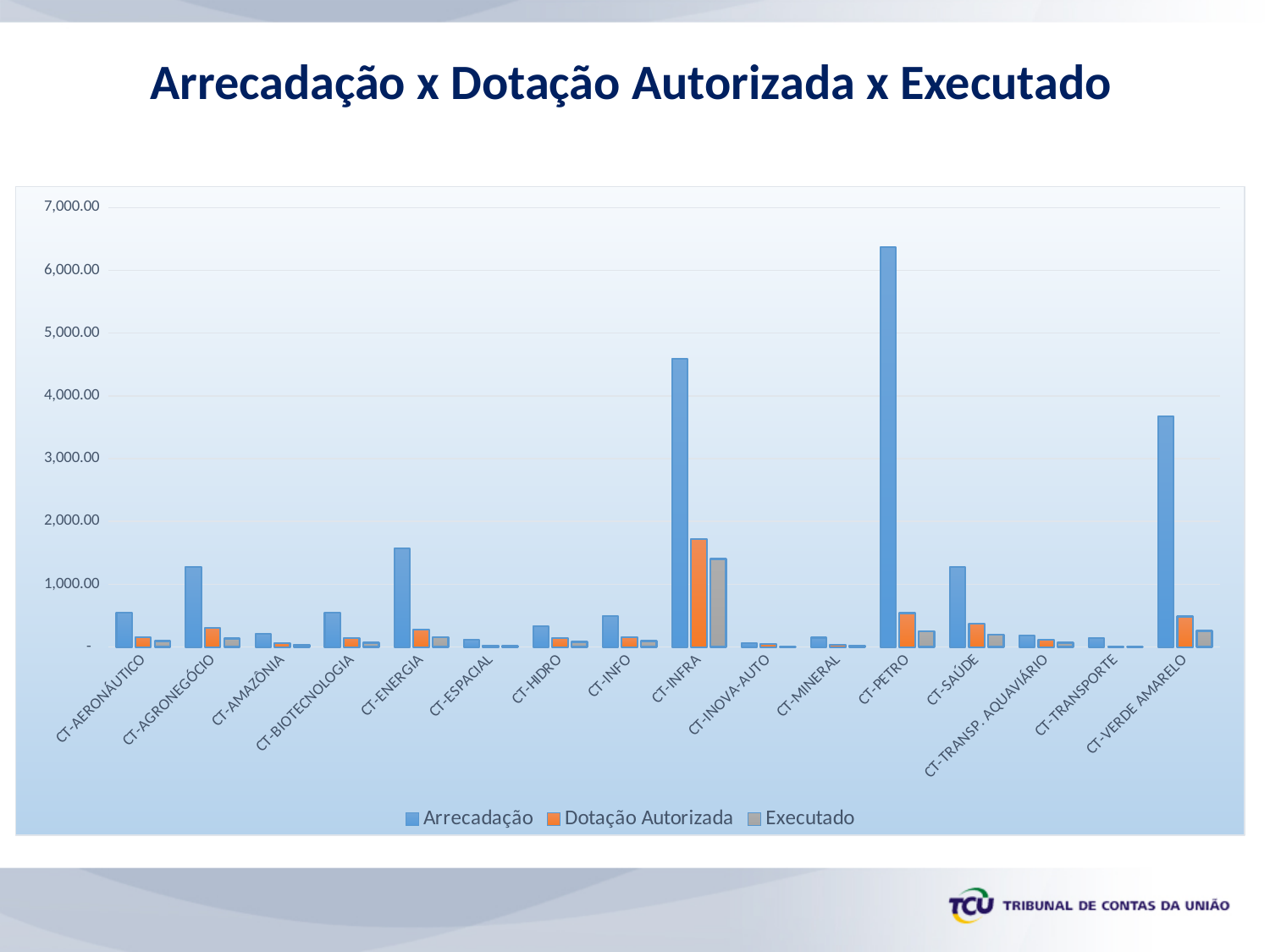
Which has the larger Arrecadação value, CT-INFRA or CT-VERDE AMARELO? CT-INFRA Which category has the highest Dotação Autorizada value? CT-INFRA Which category has the highest Executado value? CT-INFRA Which category has the highest Arrecadação value? CT-PETRO How many series does the legend list? 3 What kind of chart is shown on the slide? bar chart Is the Arrecadação value for CT-INFRA greater or less than 4,000.00? greater How many categories are shown on the x axis? 16 Is the Arrecadação value for CT-VERDE AMARELO greater or less than 3,000.00? greater Is the Dotação Autorizada value for CT-INFRA greater or less than 2,000.00? less What is the title of the chart? Arrecadação x Dotação Autorizada x Executado